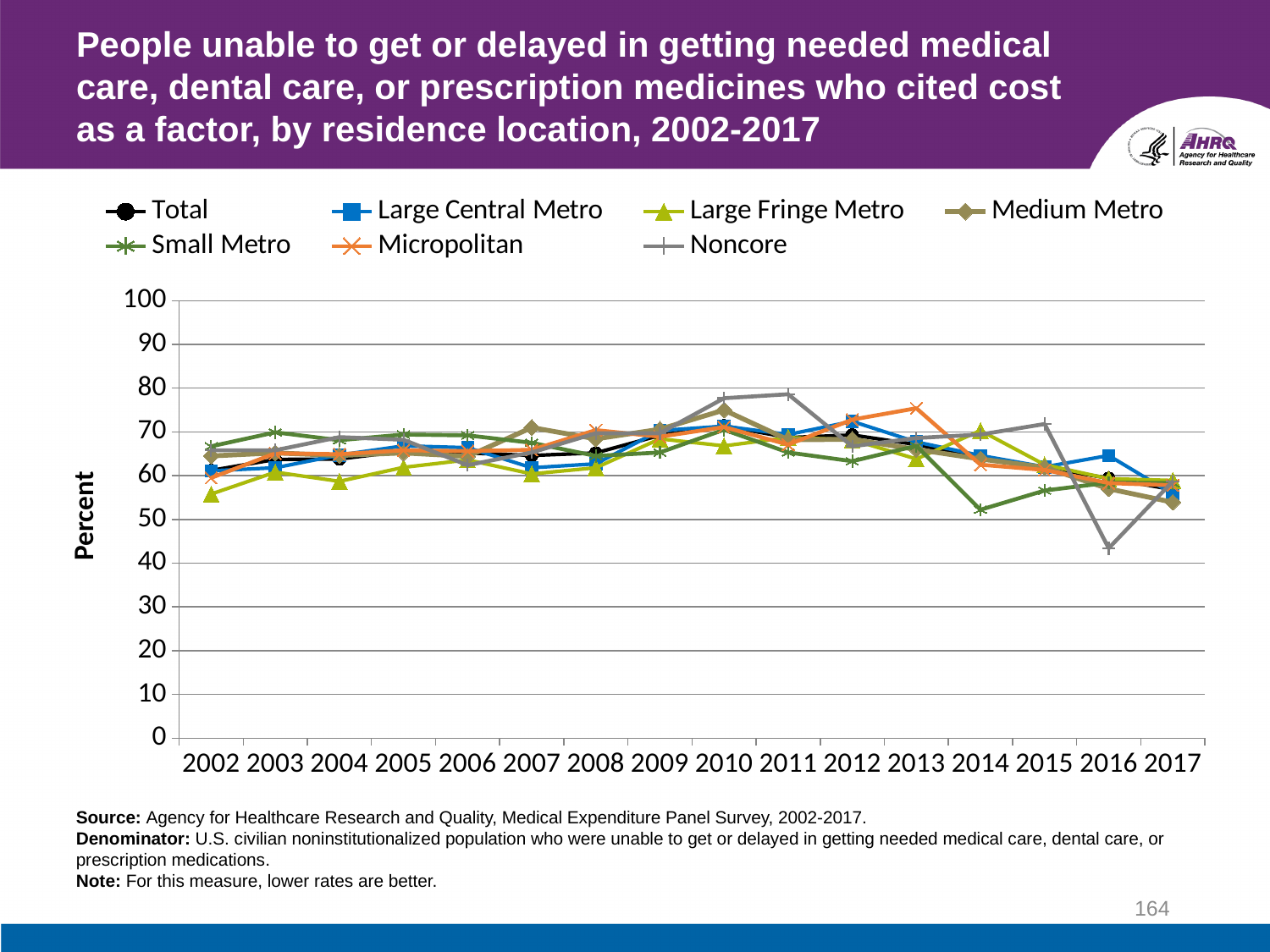
How many years are shown along the x axis? 16 What kind of chart is shown on the slide? line chart Is the value for Noncore in 2016 greater or less than 50? less Which series has the highest value in 2013? Micropolitan Is the value for Noncore in 2011 greater or less than 70? greater Is the value for Small Metro in 2014 greater or less than 60? less Does the Noncore line rise or fall from 2015 to 2016? fall Which series has the lowest value in 2016? Noncore In 2016, which is larger: the value for Large Central Metro or the value for Noncore? Large Central Metro Which series has the lowest value in 2014? Small Metro How many series does the legend list? 8